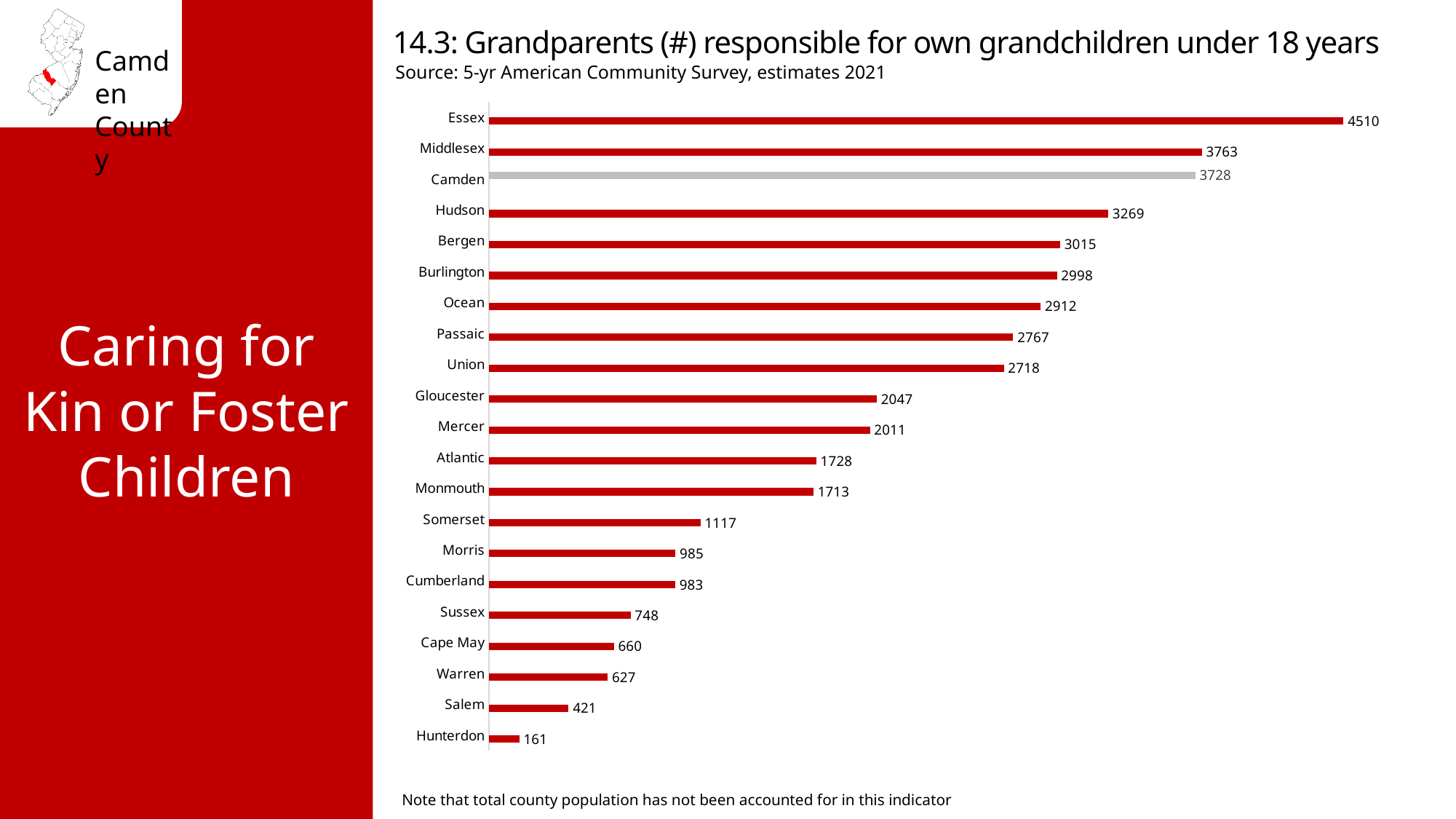
Which county's bar is shown in grey rather than red? Camden What is the difference between the values for Camden and Hudson? 459 What kind of chart is shown on the slide? Bar chart What is the value for Camden? 3728 What is the value for Hunterdon? 161 Which county has the lowest value? Hunterdon What is the value for Gloucester? 2047 How many counties are shown in the chart? 21 Which county has the highest value? Essex Which is larger, the value for Bergen or the value for Ocean? Bergen What is the difference between the values for Essex and Middlesex? 747 Which is larger, the value for Somerset or the value for Sussex? Somerset